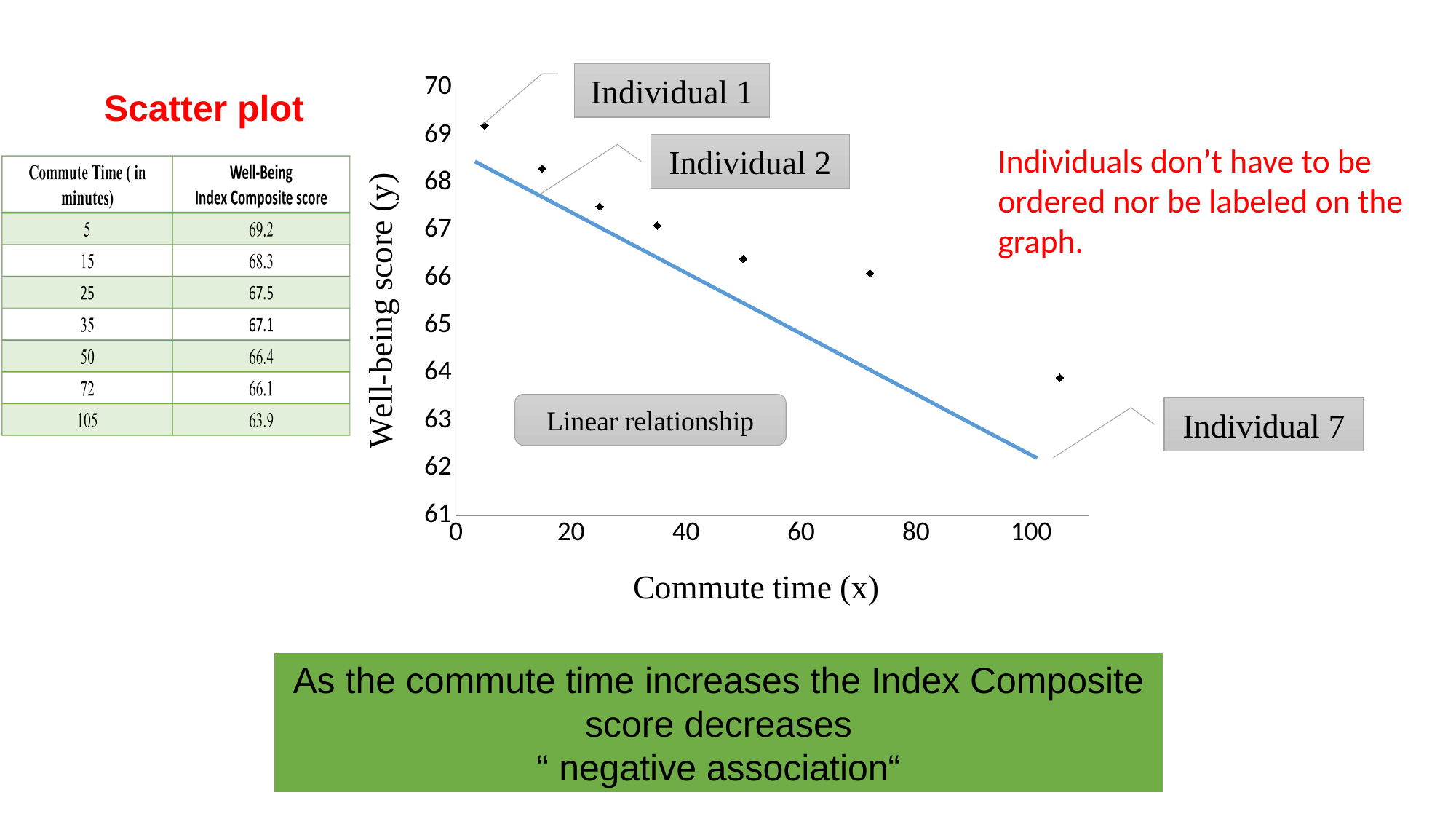
Which individual is labeled at the point with a commute time of 105 minutes? Individual 7 What is the difference between the well-being score at a commute time of 5 minutes and at 105 minutes? 5.3 Which commute time has the highest well-being score? 5 What is the Well-Being Index Composite score for a commute time of 105 minutes? 63.9 Is the well-being score for a commute time of 72 minutes greater or less than 65? greater Which commute time has the lowest well-being score? 105 What is the Well-Being Index Composite score for a commute time of 5 minutes? 69.2 Do the well-being scores rise or fall as commute time increases along the x axis? fall What kind of chart is shown on the slide? scatter plot How many data points are plotted on the scatter plot? 7 Which has the larger well-being score: a commute time of 35 minutes or 105 minutes? 35 minutes What is the label of the x axis on the scatter plot? Commute time (x)